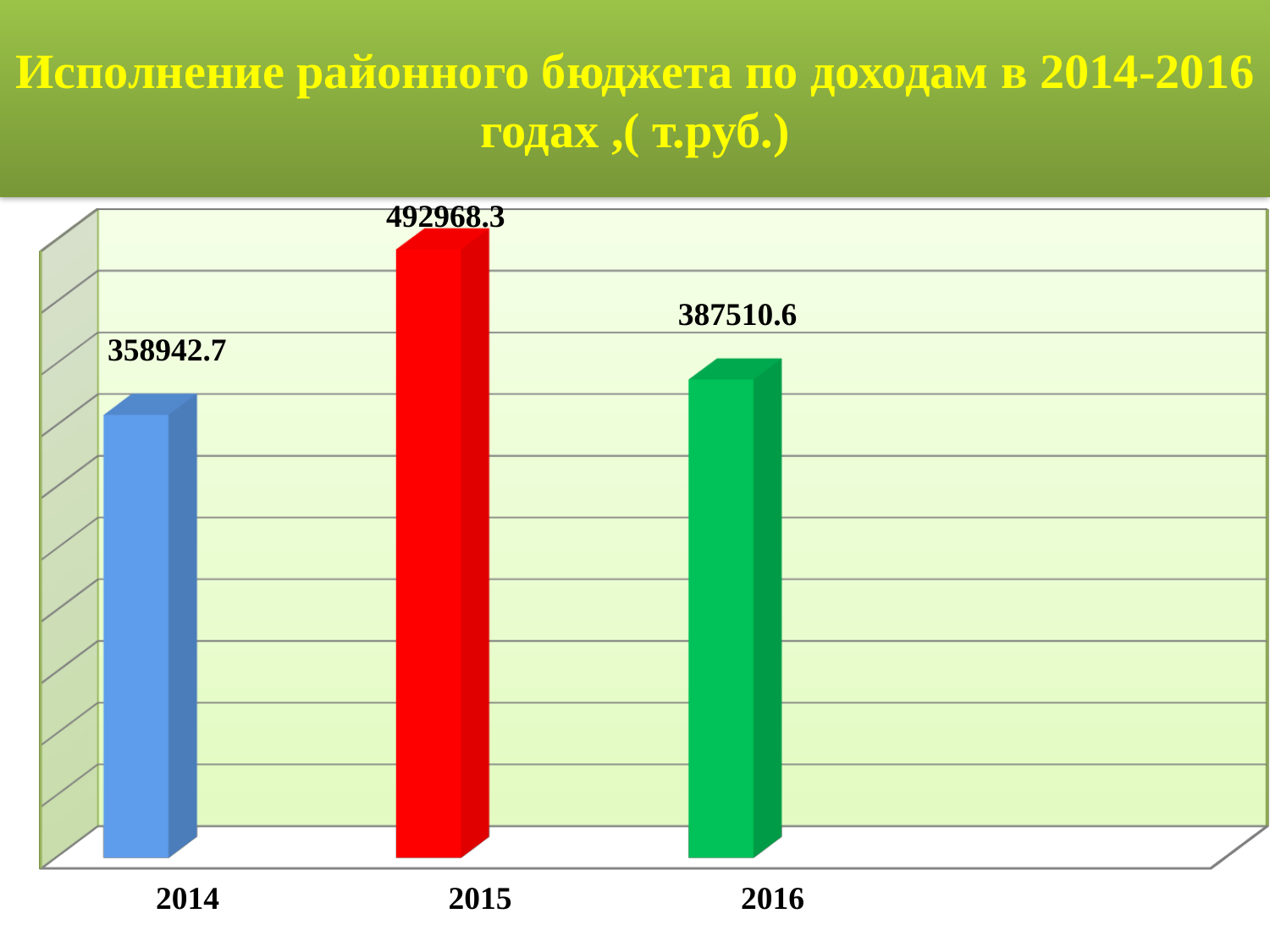
What is the value for 2015? 492968.3 What colour is the bar for 2015? Red What is the difference between the values for 2016 and 2014? 28567.9 What is the value for 2016? 387510.6 How many years are shown on the chart? 3 What is the value for 2014? 358942.7 Which is larger, the value for 2016 or the value for 2014? 2016 Which year has the lowest value? 2014 What kind of chart is shown on the slide? Bar chart What is the difference between the values for 2015 and 2014? 134025.6 What is the difference between the values for 2015 and 2016? 105457.7 Which year has the highest value? 2015